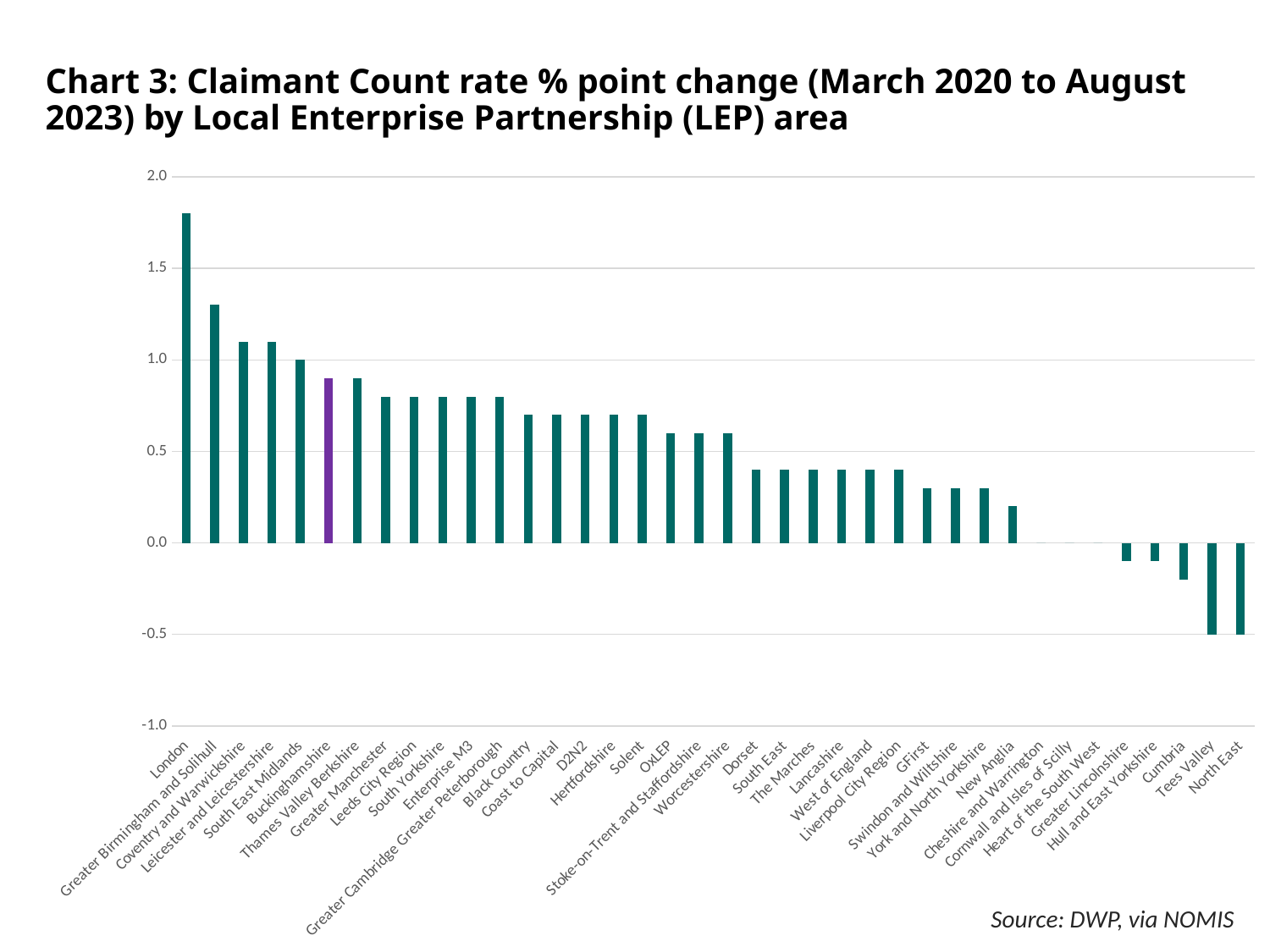
Which LEP area has the highest Claimant Count rate % point change? London Do the values generally rise or fall moving from left to right along the x axis? Fall Which has the larger value, London or Greater Birmingham and Solihull? London Is the value for London greater or less than 1.5? greater What is the Claimant Count rate % point change for South East Midlands? 1.0 How many LEP areas are listed along the x axis? 38 What kind of chart is shown on the slide? Bar chart Is the value for Greater Birmingham and Solihull greater or less than 1.5? less Which LEP area's bar is coloured purple rather than green? Buckinghamshire Is the value for Cumbria greater or less than 0.0? less What is the Claimant Count rate % point change for Tees Valley? -0.5 Which has the larger value, Greater Lincolnshire or Cumbria? Greater Lincolnshire